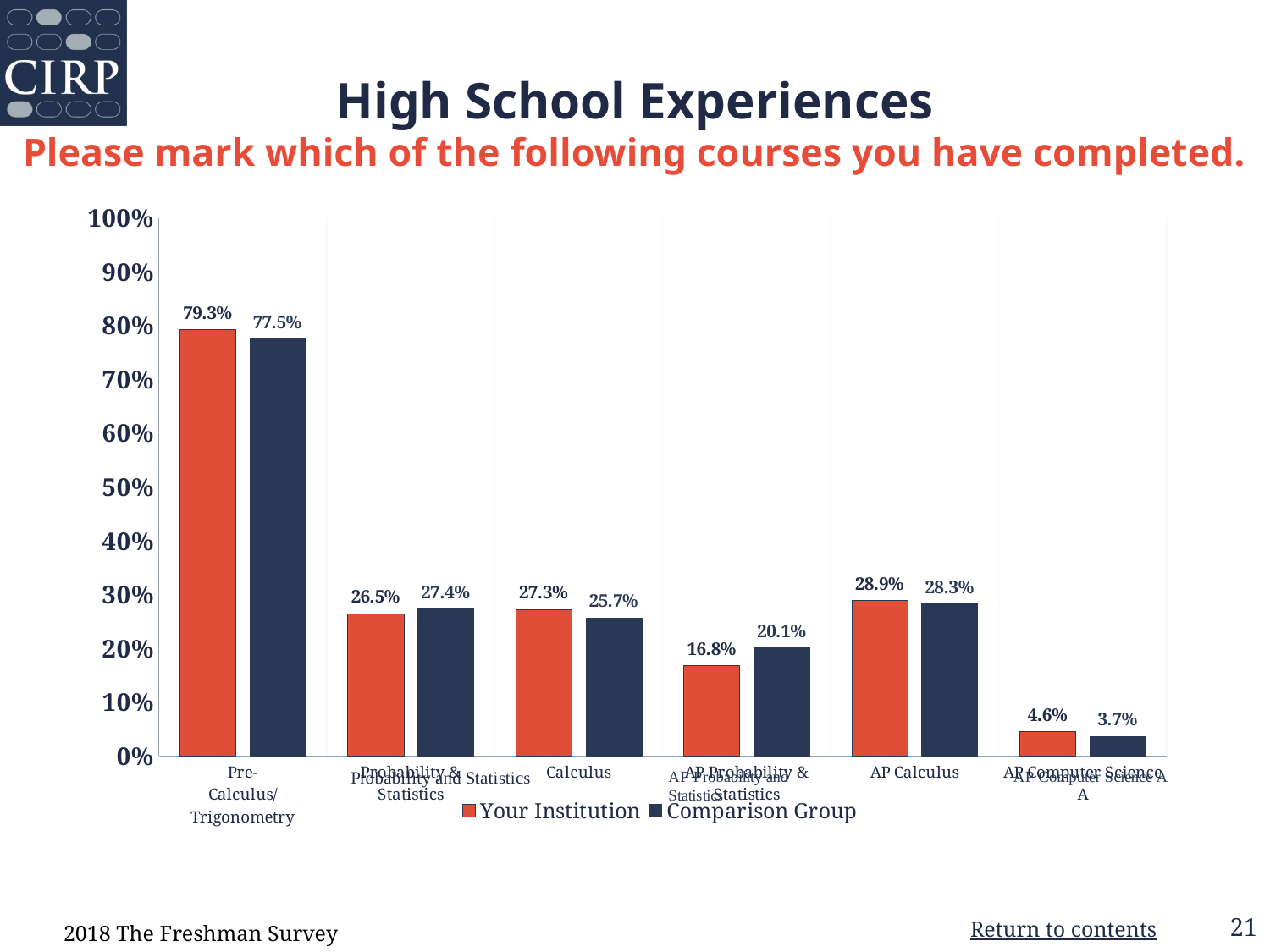
Which course has the highest completion rate for the Comparison Group? Pre-Calculus/Trigonometry What kind of chart is shown on the slide? Bar chart Which course has the lowest completion rate for Your Institution? AP Computer Science A What is the Comparison Group value for AP Probability & Statistics? 20.1% What is the difference between the Your Institution and Comparison Group values for Pre-Calculus/Trigonometry? 1.8% How many courses are shown on the x axis? 6 What is the Your Institution value for AP Computer Science A? 4.6% Is the Your Institution value for AP Calculus greater or less than 20%? greater What is the difference between the Your Institution and Comparison Group values for Calculus? 1.6% How many series does the legend list? 2 What percentage of Your Institution students completed Pre-Calculus/Trigonometry? 79.3% For AP Probability & Statistics, which is larger: Your Institution or Comparison Group? Comparison Group